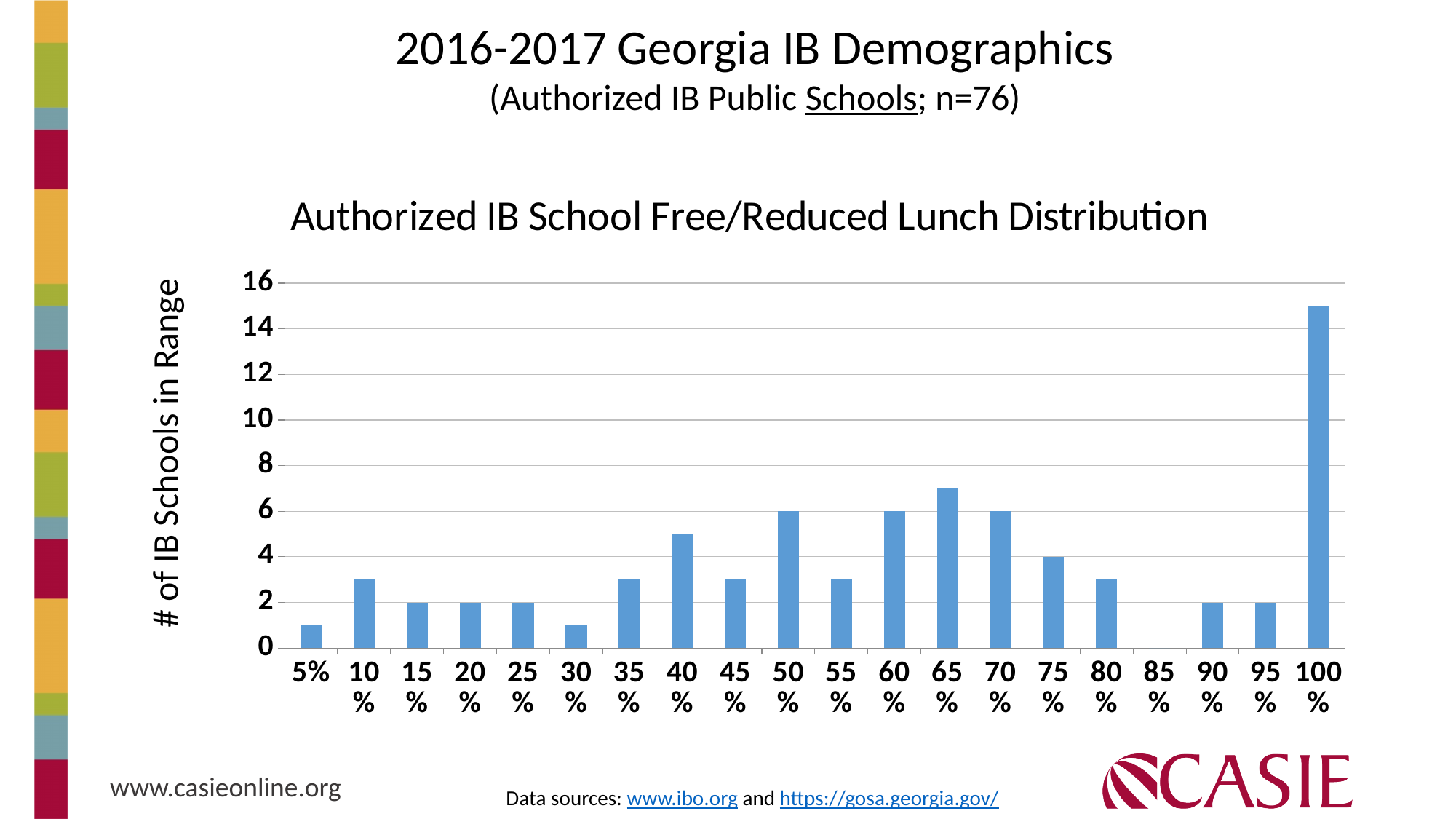
How many IB schools are in the 90% range? 2 How many percentage categories are shown along the x axis? 20 Is the value for 5% greater or less than 2? less Is the value for 100% greater or less than 14? greater How many IB schools are in the 50% range? 6 What type of chart is shown on the slide? bar chart Which category has no bar at all (zero schools)? 85% Which category has the highest number of IB schools? 100% What is the title of the chart? Authorized IB School Free/Reduced Lunch Distribution What is the difference between the number of schools in the 50% range and the 75% range? 2 How many IB schools are in the 75% range? 4 What is the label on the vertical axis of the chart? # of IB Schools in Range